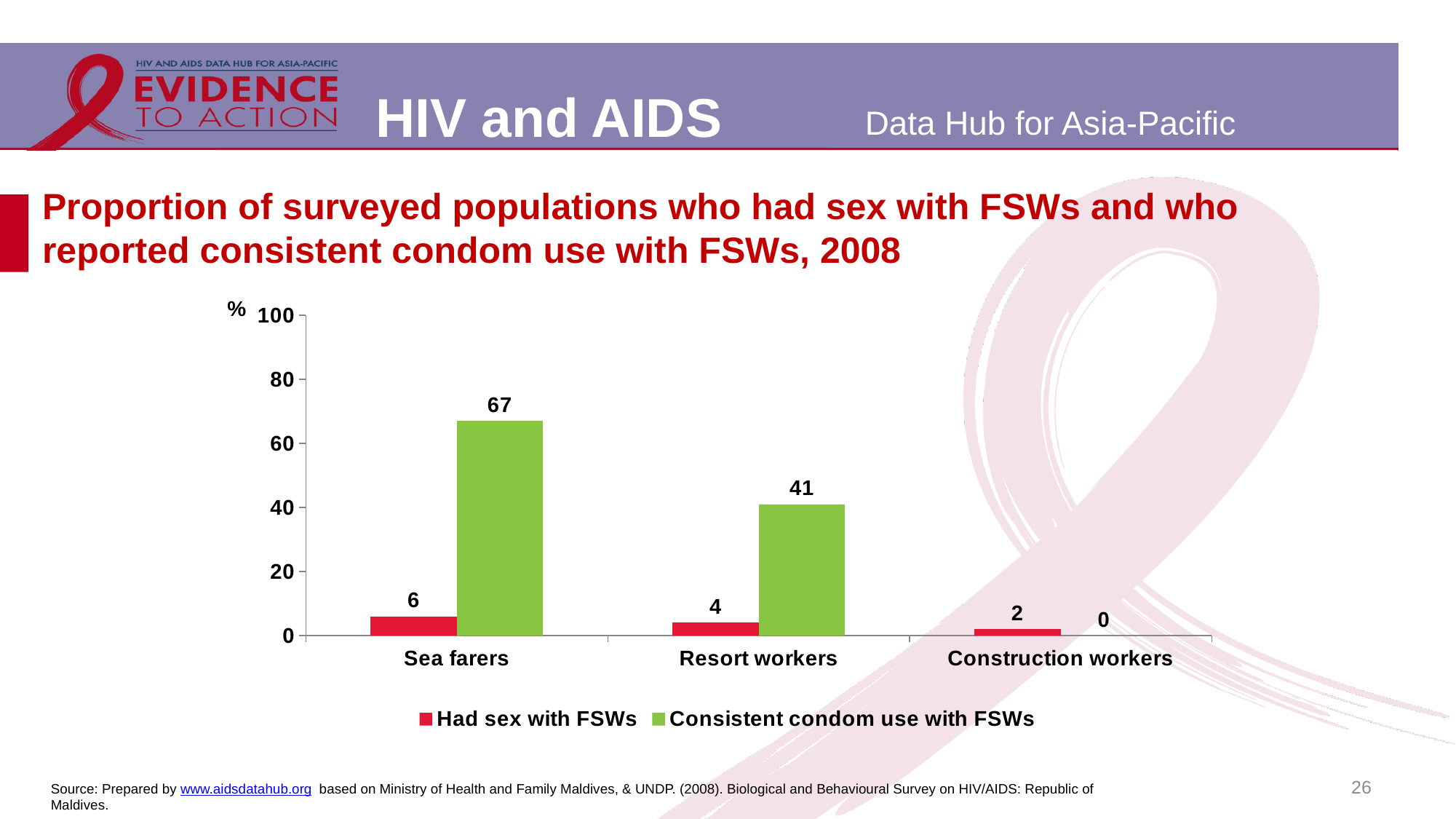
What is the difference between the consistent condom use values for sea farers and resort workers? 26 Which is larger: the proportion of sea farers who had sex with FSWs or the proportion of construction workers who had sex with FSWs? Sea farers Which colour represents the 'Had sex with FSWs' series? Red Which population has the lowest proportion who had sex with FSWs? Construction workers What percentage of resort workers had sex with FSWs? 4 Is the consistent condom use value for resort workers greater or less than 60? less What type of chart is shown on the slide? Bar chart How many series does the legend list? 2 What is the value for consistent condom use with FSWs among construction workers? 0 Which population has the highest proportion reporting consistent condom use with FSWs? Sea farers What percentage of sea farers reported consistent condom use with FSWs? 67 How many population groups are shown on the x axis? 3